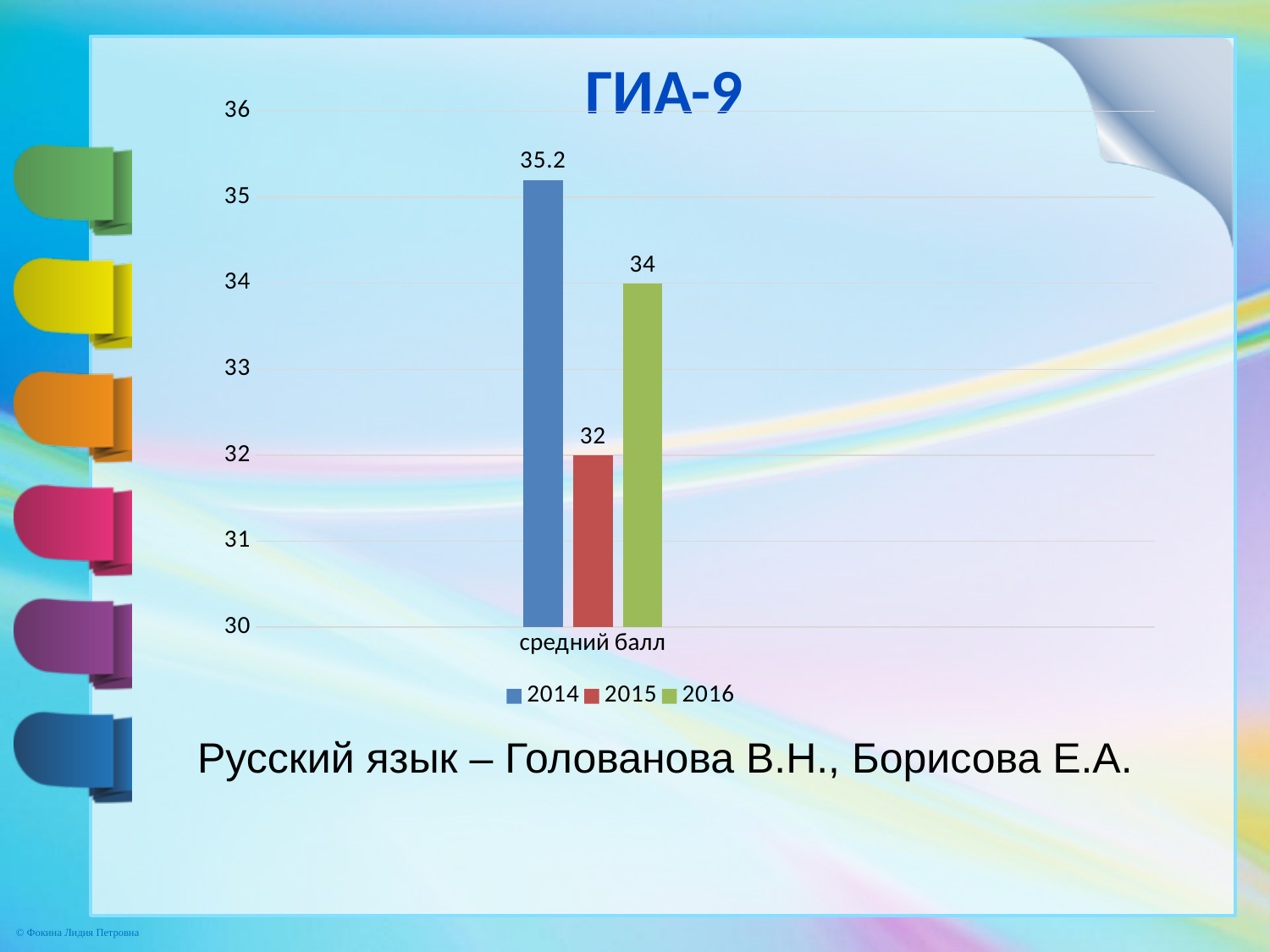
Which year has the highest average score? 2014 How many series does the legend list? 3 What is the title of the chart? ГИА-9 What is the value for 2016 in the chart? 34 What is the difference between the 2016 and 2015 values? 2 What kind of chart is shown on the slide? bar chart Which year has the lowest average score? 2015 What is the value for 2014 in the chart? 35.2 What is the value for 2015 in the chart? 32 Which is larger, the value for 2016 or the value for 2015? 2016 Is the value for 2014 greater or less than 35? greater What is the difference between the 2014 and 2015 values? 3.2